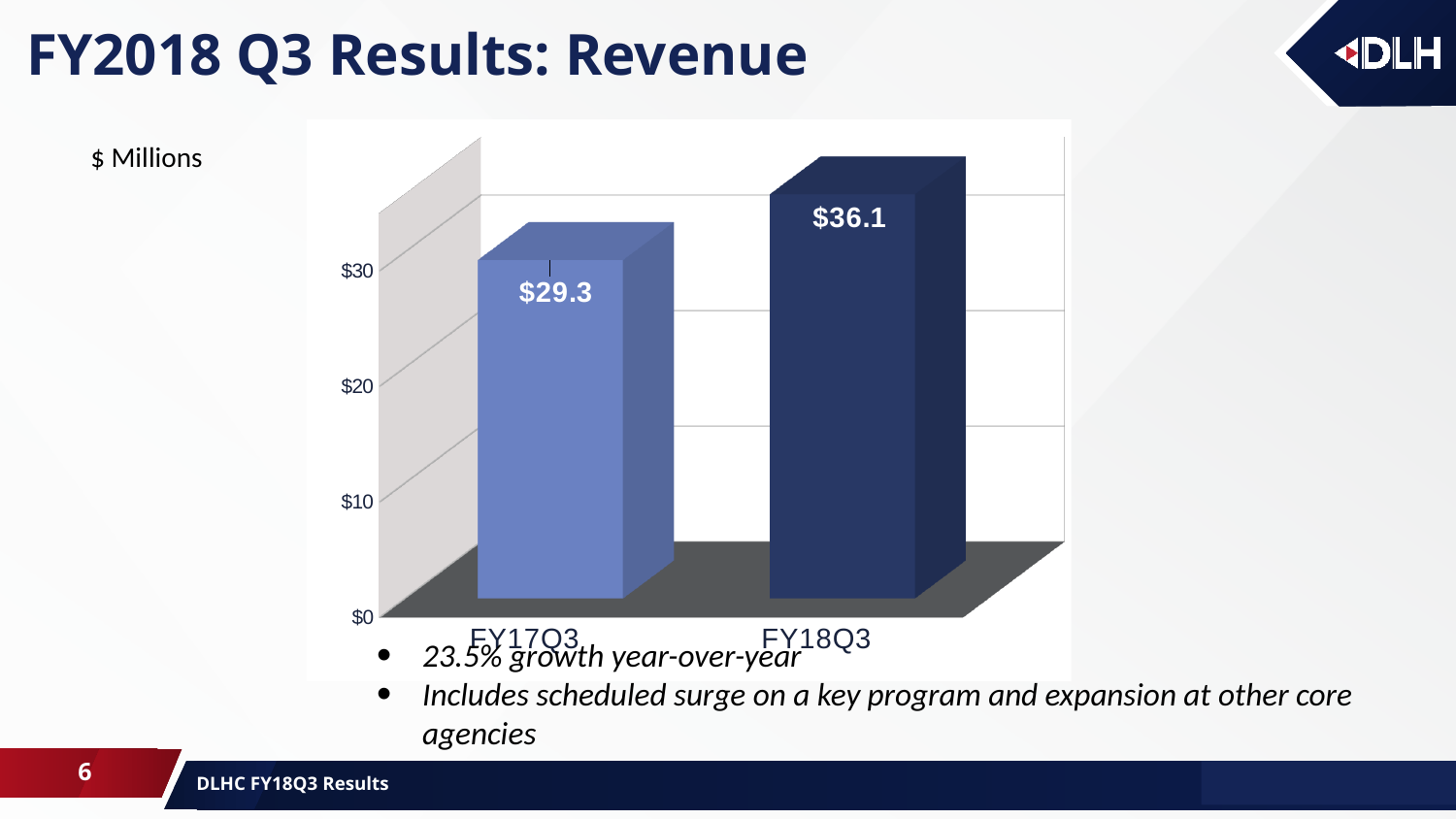
How many categories are shown on the x axis of the chart? 2 Is the value for FY17Q3 greater or less than $20? greater Is the value for FY18Q3 greater or less than $30? greater What is the revenue value for FY18Q3? $36.1 Is the revenue for FY18Q3 larger or smaller than the revenue for FY17Q3? larger What is the revenue value for FY17Q3? $29.3 Which quarter has the lower revenue? FY17Q3 Do the values rise or fall from FY17Q3 to FY18Q3? rise What unit label is shown next to the chart? $ Millions What is the difference between the FY18Q3 and FY17Q3 revenue values? $6.8 What kind of chart is shown on the slide? bar chart Which quarter has the higher revenue? FY18Q3